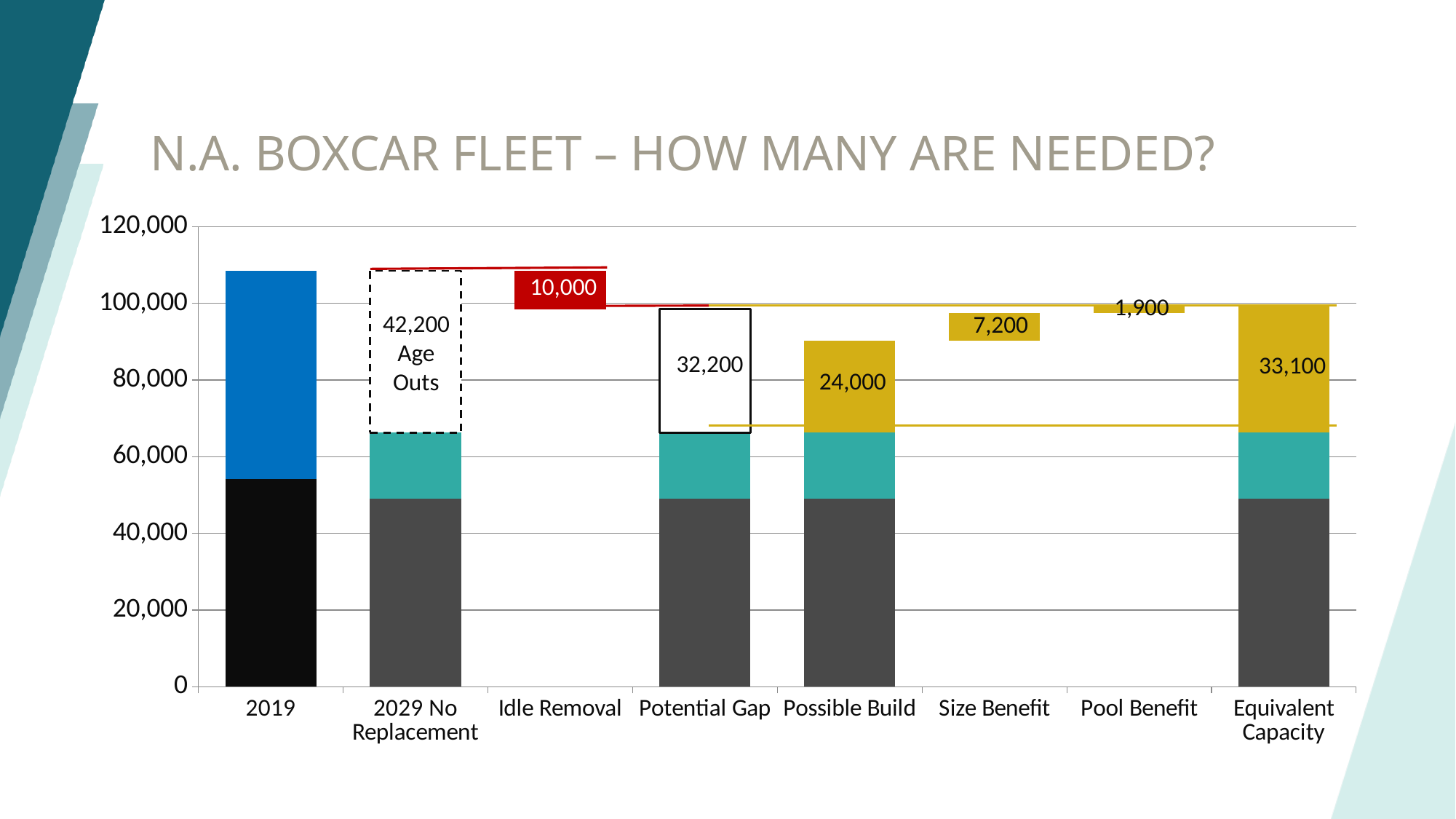
What is the difference between the labelled values for Possible Build and Size Benefit? 16,800 What value is labelled on the Idle Removal bar? 10,000 How many Age Outs are labelled on the 2029 No Replacement bar? 42,200 What value is labelled on the Pool Benefit bar? 1,900 What is the title of the chart? N.A. BOXCAR FLEET – HOW MANY ARE NEEDED? Which of Possible Build, Size Benefit and Pool Benefit has the smallest labelled value? Pool Benefit What value is labelled on the Equivalent Capacity bar? 33,100 What value is labelled on the Potential Gap bar? 32,200 What value is labelled on the Possible Build bar? 24,000 Is the total height of the 2019 bar greater or less than 100,000? greater What kind of chart is shown on the slide? bar chart How many categories are shown along the x axis? 8